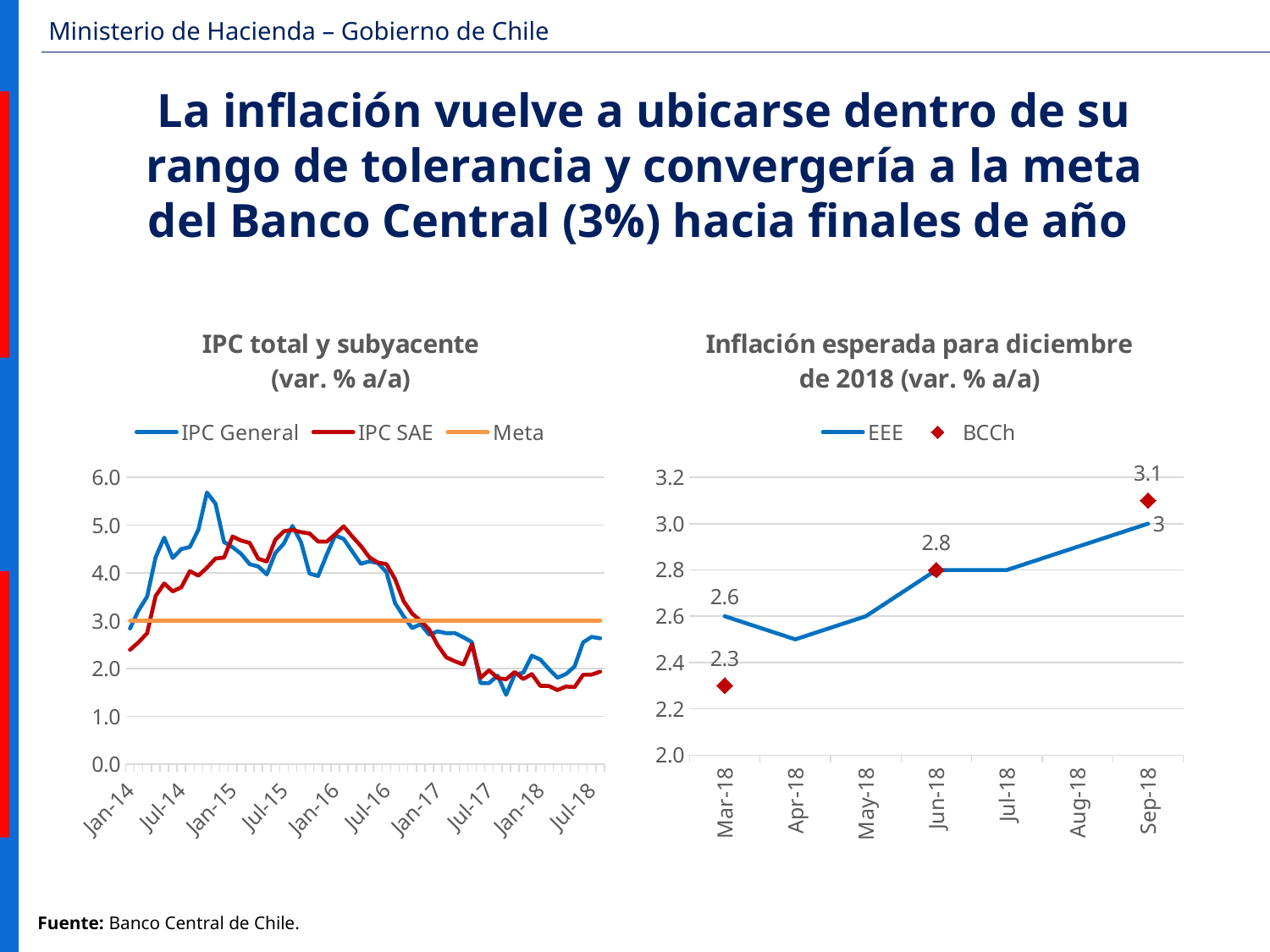
In the chart 'Inflación esperada para diciembre de 2018', which is larger for Mar-18, EEE or BCCh? EEE In the chart 'Inflación esperada para diciembre de 2018', what is the BCCh value for Sep-18? 3.1 In the chart 'Inflación esperada para diciembre de 2018', what is the EEE value for Mar-18? 2.6 What kind of chart is 'IPC total y subyacente (var. % a/a)'? line chart In the chart 'Inflación esperada para diciembre de 2018', what is the BCCh value for Mar-18? 2.3 In the chart 'Inflación esperada para diciembre de 2018', does the EEE series rise or fall from Mar-18 to Sep-18? rise In the chart 'Inflación esperada para diciembre de 2018', what is the difference between the BCCh and EEE values for Sep-18? 0.1 In the chart 'Inflación esperada para diciembre de 2018', what is the difference between the EEE and BCCh values for Mar-18? 0.3 In the chart 'Inflación esperada para diciembre de 2018', how many months are shown on the x axis? 7 In the chart 'IPC total y subyacente', how many series does the legend list? 3 In the chart 'IPC total y subyacente', is the IPC General value for Jan-18 greater or less than 3.0? less In the chart 'Inflación esperada para diciembre de 2018', how many series does the legend list? 2